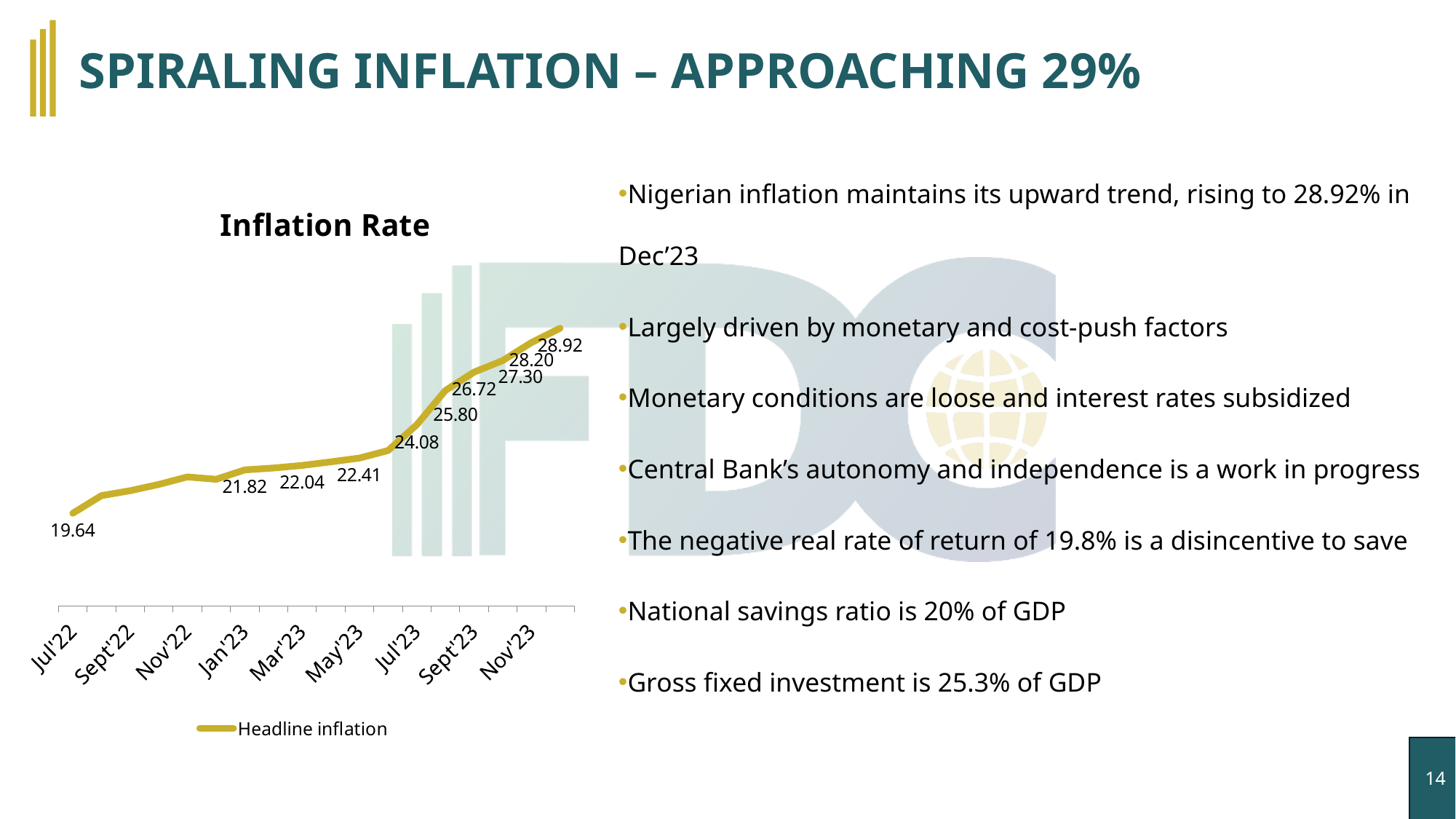
Which is larger on the chart: the value at Jul'22 or the value at the final point of the line? the final point Does headline inflation rise or fall from Jul'22 to the end of the series on the chart? rise What is the difference between the highest labelled value (28.92) and the lowest labelled value (19.64) on the chart? 9.28 What kind of chart is the 'Inflation Rate' chart? line chart How many data labels are printed on the headline inflation line? 10 What is the headline inflation value at Jul'22 on the chart? 19.64 What series name does the chart legend show? Headline inflation What is the lowest headline inflation value labelled on the chart? 19.64 How many series does the legend of the 'Inflation Rate' chart list? 1 What is the highest headline inflation value labelled on the chart? 28.92 What is the difference between the last two labelled values on the chart, 28.92 and 28.20? 0.72 What is the title of the chart on the slide? Inflation Rate